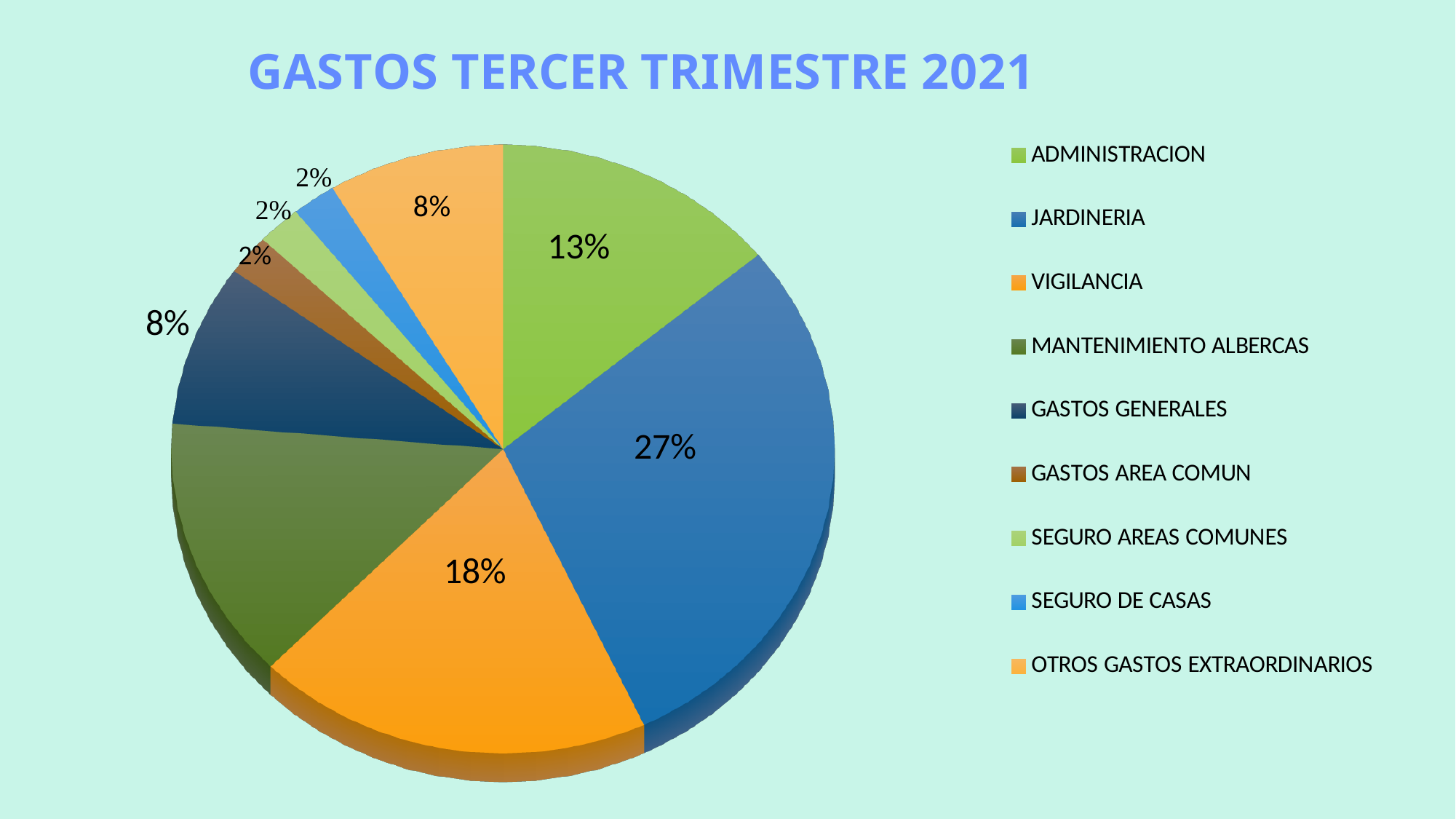
What is the difference in percentage points between JARDINERIA and VIGILANCIA? 9 percentage points What is the value shown for VIGILANCIA? 18% What percentage of the pie does JARDINERIA represent? 27% How many categories does the legend list? 9 What is the value shown for OTROS GASTOS EXTRAORDINARIOS? 8% What kind of chart is shown on the slide? pie chart Which category has the largest slice of the pie? JARDINERIA What is the value shown for ADMINISTRACION? 13% What is the value shown for GASTOS GENERALES? 8% What is the value shown for SEGURO DE CASAS? 2% What is the title of the chart? GASTOS TERCER TRIMESTRE 2021 Which is larger, ADMINISTRACION or VIGILANCIA? VIGILANCIA